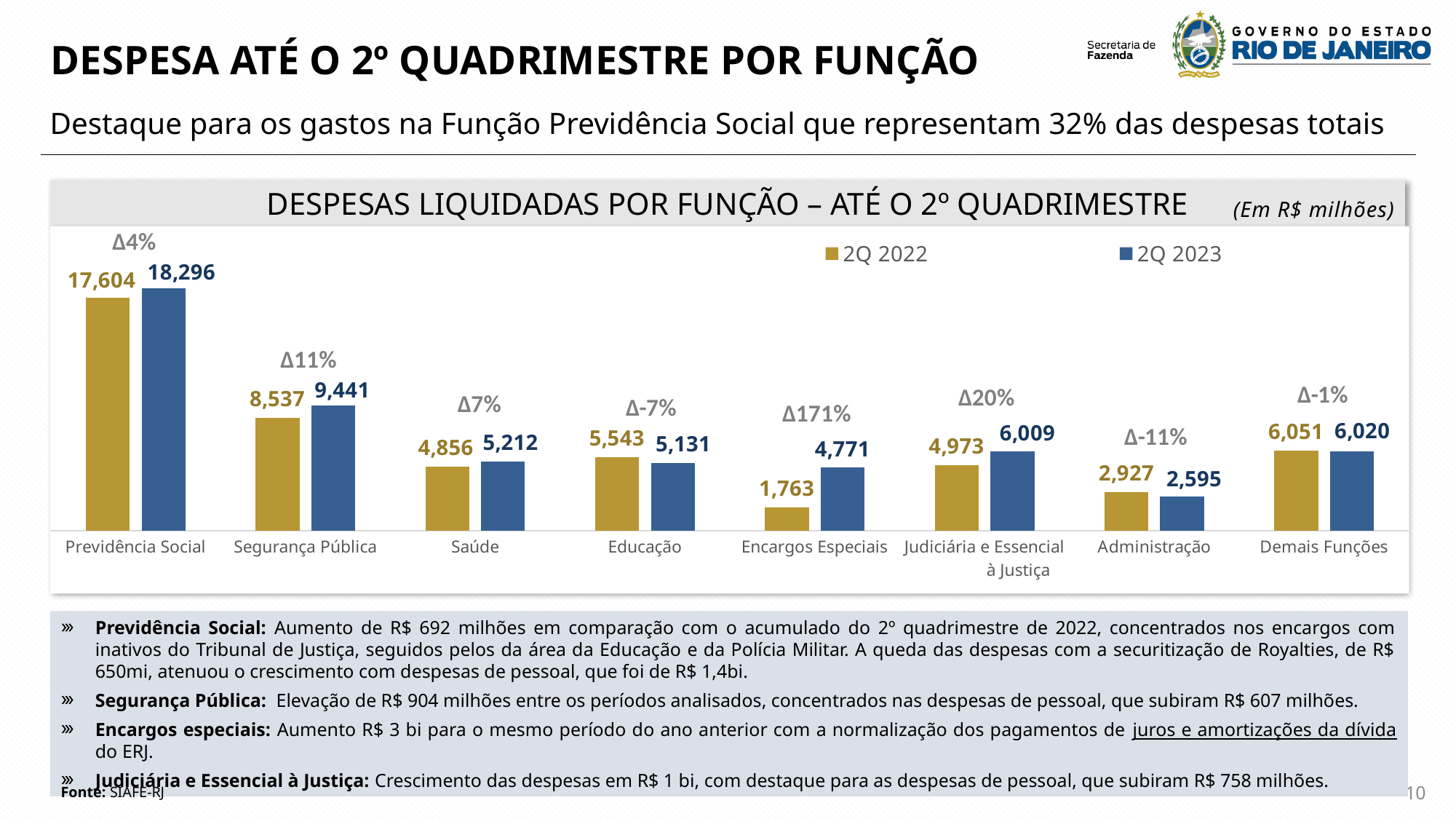
What is the difference between the 2Q 2023 and 2Q 2022 values for Segurança Pública? 904 Which category has the highest 2Q 2023 value? Previdência Social How many categories are shown on the x axis? 8 What percentage change is shown above the Encargos Especiais bars? Δ171% How many series does the legend list? 2 What is the 2Q 2023 value for Administração? 2,595 Which is larger for Educação: the 2Q 2022 value or the 2Q 2023 value? 2Q 2022 What unit is stated for the chart values? Em R$ milhões Which category has the lowest 2Q 2022 value? Encargos Especiais What is the 2Q 2022 value for Encargos Especiais? 1,763 What kind of chart is shown? Bar chart What is the 2Q 2023 value for Previdência Social? 18,296